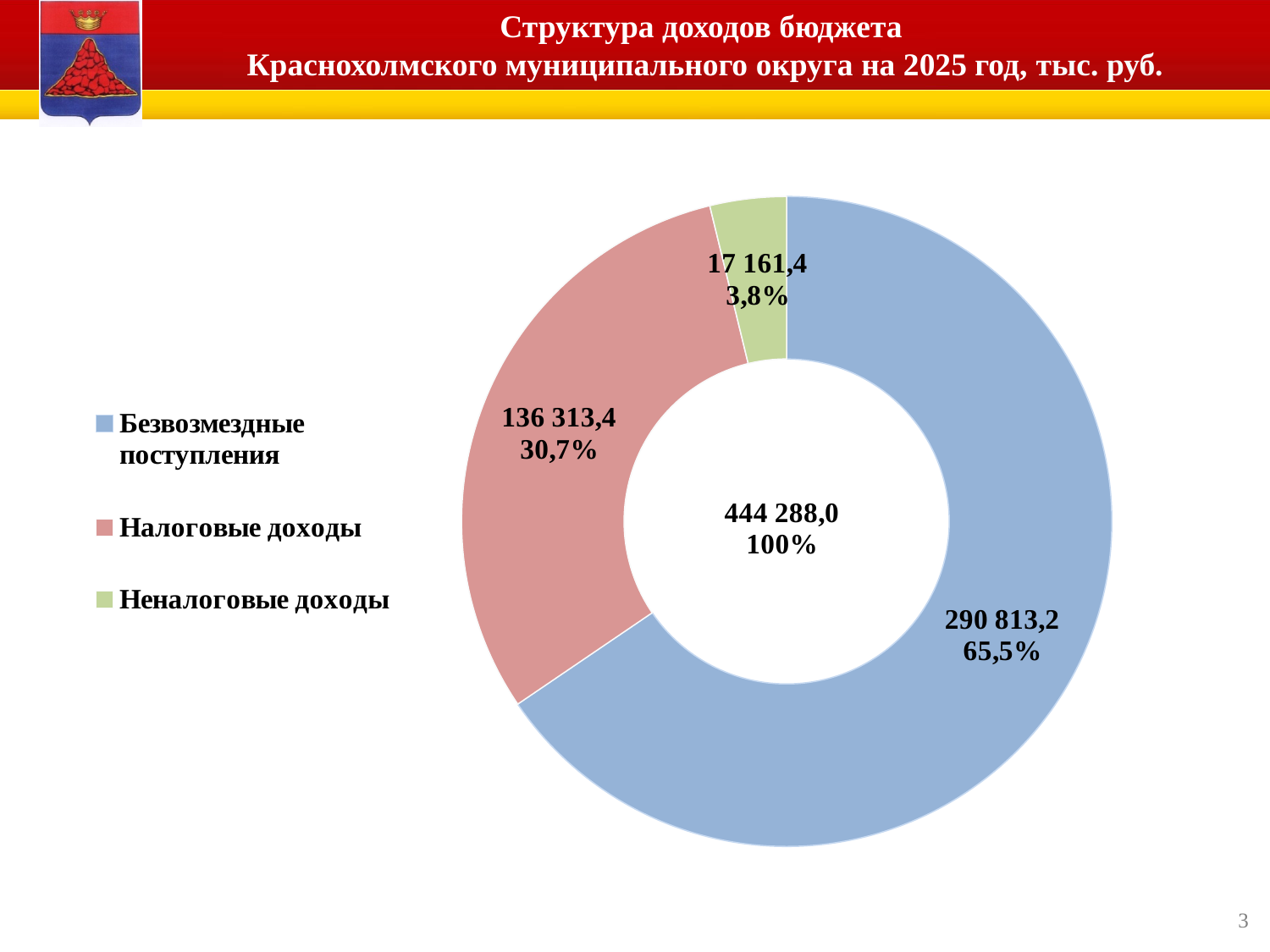
Which category has the smallest value? Неналоговые доходы What is the value for Безвозмездные поступления? 290 813,2 How many categories does the chart show? 3 What kind of chart is shown on the slide? Doughnut (pie) chart What is the value for Налоговые доходы? 136 313,4 What share of the total do Безвозмездные поступления make up? 65,5% What share of the total do Неналоговые доходы make up? 3,8% Which category has the largest value? Безвозмездные поступления Which is larger, Налоговые доходы or Неналоговые доходы? Налоговые доходы What is the value for Неналоговые доходы? 17 161,4 What share of the total do Налоговые доходы make up? 30,7% What is the difference between Безвозмездные поступления and Налоговые доходы? 154 499,8